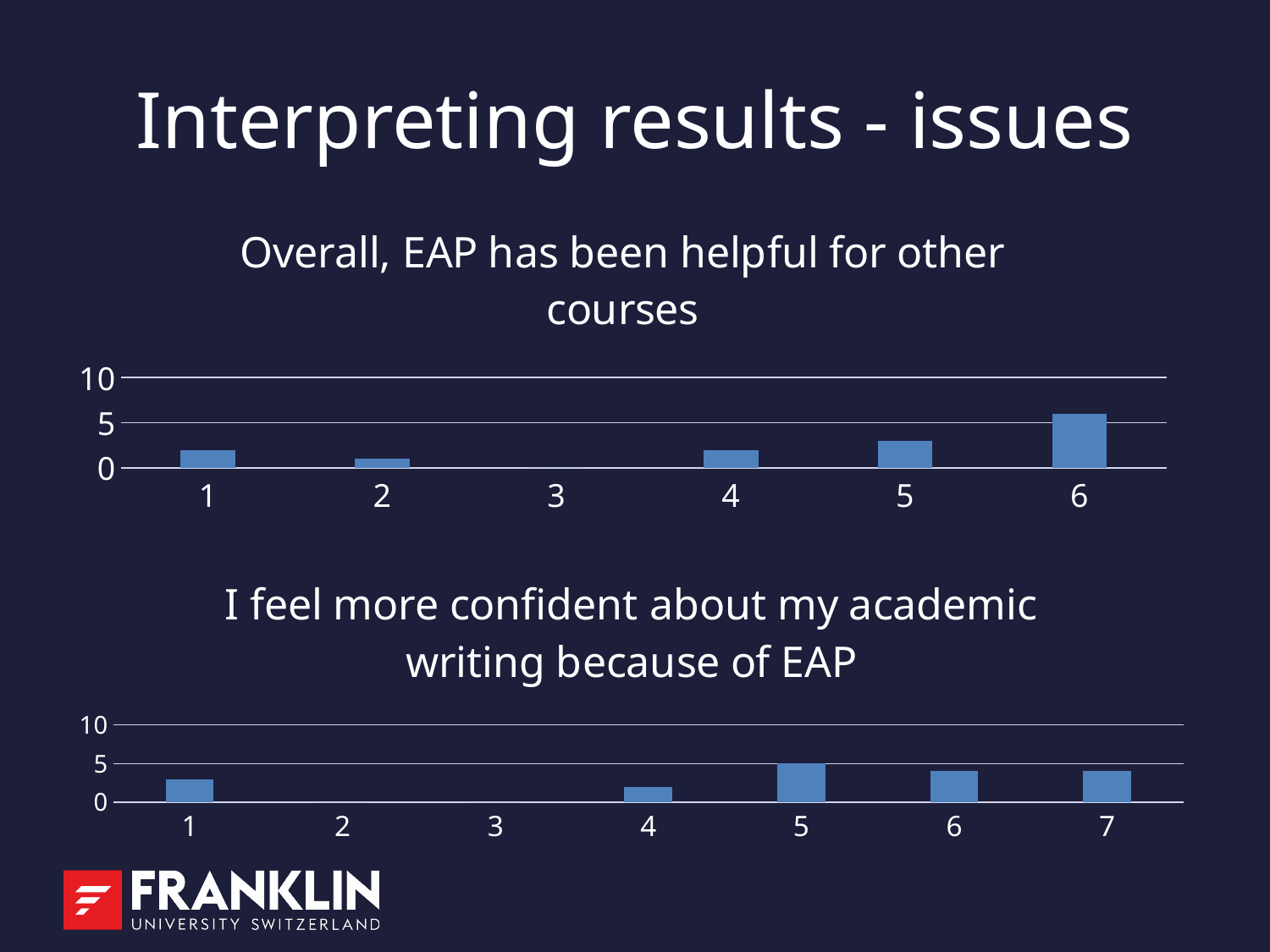
In the top chart ("Overall, EAP has been helpful for other courses"), which category has the highest bar? 6 In the top chart ("Overall, EAP has been helpful for other courses"), which is larger, the value for category 5 or the value for category 2? category 5 What is the title of the top chart on the slide? Overall, EAP has been helpful for other courses What is the title of the bottom chart on the slide? I feel more confident about my academic writing because of EAP In the bottom chart ("I feel more confident about my academic writing because of EAP"), which is larger, the value for category 1 or the value for category 4? category 1 In the bottom chart ("I feel more confident about my academic writing because of EAP"), is the value for category 5 greater or less than 10? less In the top chart ("Overall, EAP has been helpful for other courses"), is the value for category 1 greater or less than 5? less In the top chart ("Overall, EAP has been helpful for other courses"), is the value for category 6 greater or less than 5? greater What kind of chart is the top chart, titled "Overall, EAP has been helpful for other courses"? bar chart In the top chart ("Overall, EAP has been helpful for other courses"), how many categories are shown on the x axis? 6 In the bottom chart ("I feel more confident about my academic writing because of EAP"), which category has the highest bar? 5 In the bottom chart ("I feel more confident about my academic writing because of EAP"), how many categories are shown on the x axis? 7